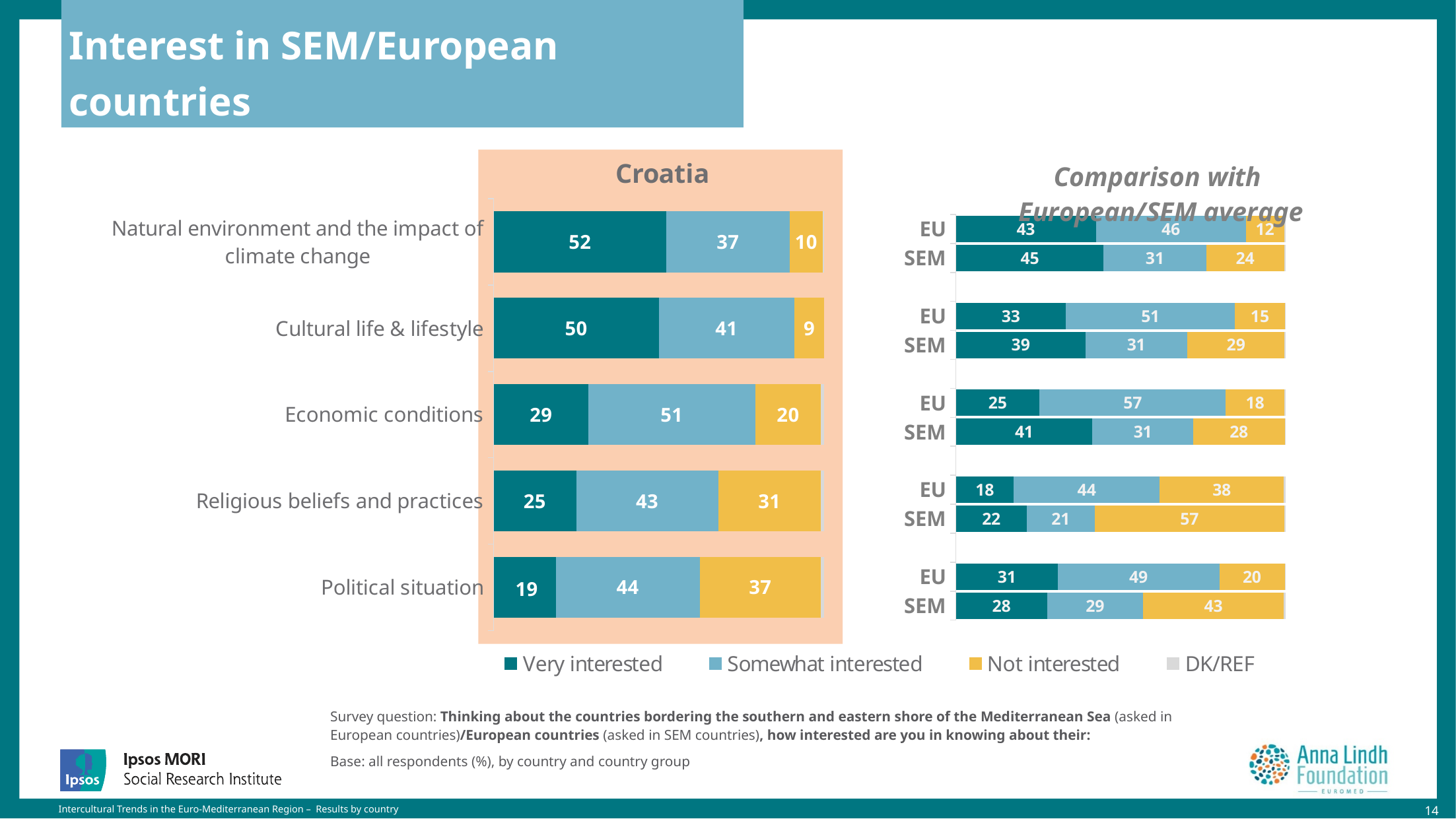
In the Croatia chart, what is the difference between the 'Somewhat interested' values for economic conditions and cultural life & lifestyle? 10 In the Comparison with European/SEM average chart, what is the EU 'Somewhat interested' value for economic conditions? 57 In the Croatia chart, what is the 'Not interested' value for the political situation? 37 What type of chart is the Croatia chart? Stacked bar chart In the Comparison with European/SEM average chart, what is the total of the SEM bar for the political situation? 100 How many series does the legend list? 4 In the Croatia chart, which is larger: the 'Not interested' value for religious beliefs and practices or for economic conditions? Religious beliefs and practices In the Croatia chart, what percentage are very interested in the natural environment and the impact of climate change? 52 How many topic categories does the Croatia chart show? 5 In the Comparison with European/SEM average chart, what is the SEM 'Not interested' value for religious beliefs and practices? 57 In the Croatia chart, which topic has the lowest 'Very interested' value? Political situation In the Croatia chart, which topic has the highest 'Very interested' value? Natural environment and the impact of climate change